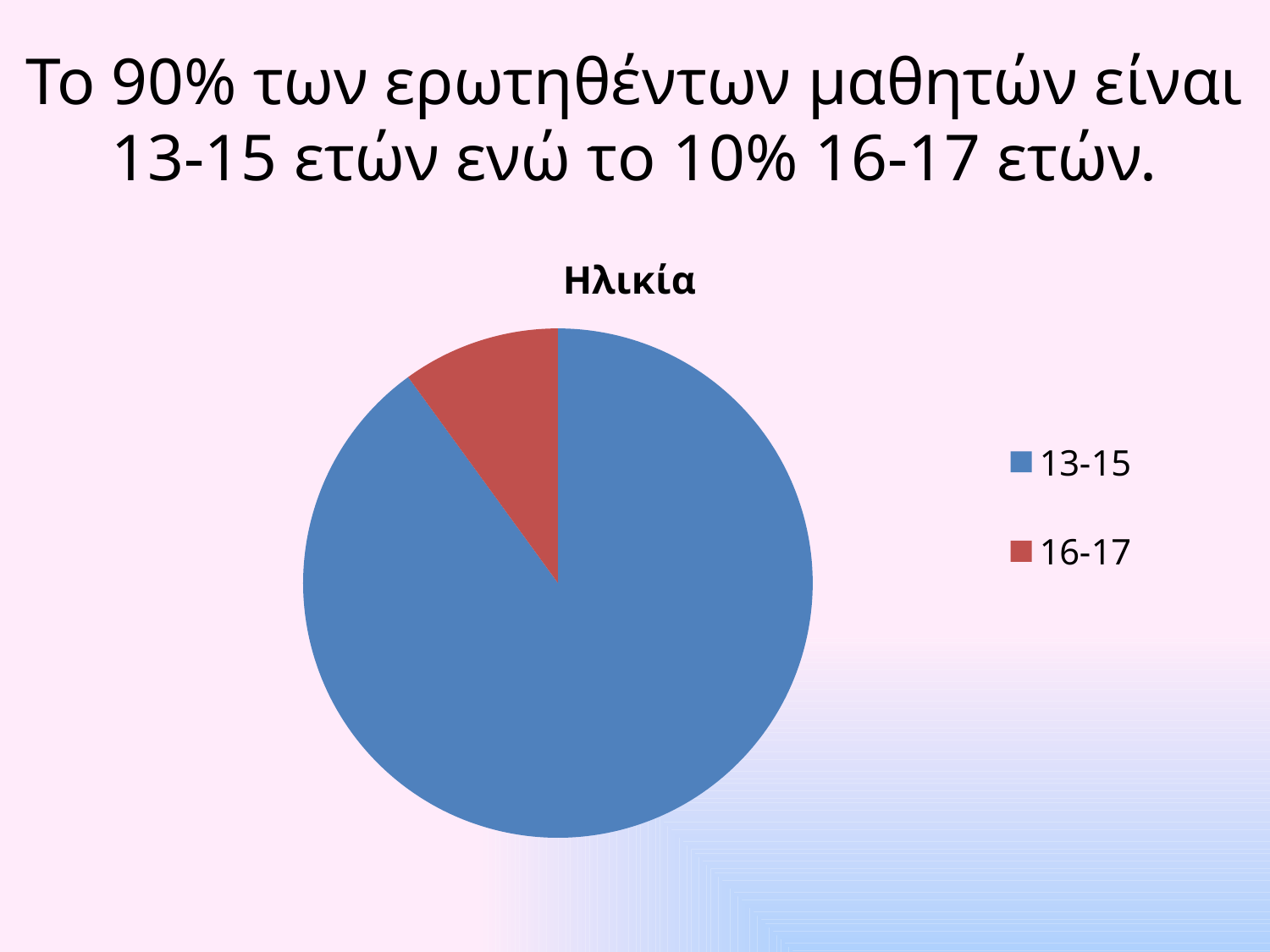
Which slice is larger, 13-15 or 16-17? 13-15 What is the title of the chart? Ηλικία What share of the pie does the 13-15 age group represent, according to the slide? 90% What colour is the slice for the 16-17 age group? red What kind of chart is shown on the slide? pie chart Which age group has the smallest slice of the pie? 16-17 How many slices does the pie chart have? 2 Which age group has the largest slice of the pie? 13-15 What is the difference in percentage points between the 13-15 and 16-17 shares stated on the slide? 80 How many entries does the legend list? 2 What share of the pie does the 16-17 age group represent, according to the slide? 10%